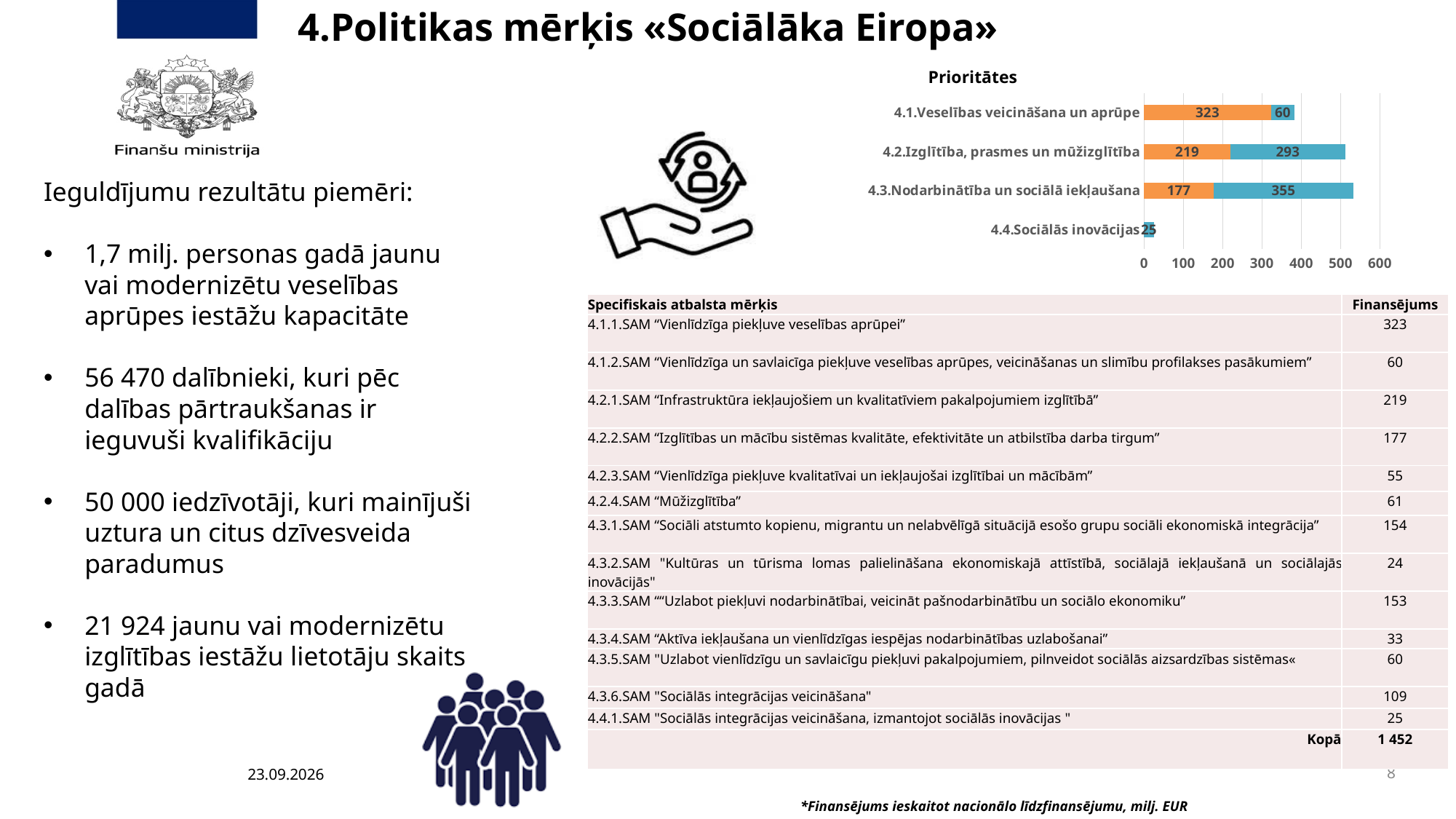
In the Prioritātes chart, which is larger: the blue segment for 4.3.Nodarbinātība un sociālā iekļaušana or the blue segment for 4.2.Izglītība, prasmes un mūžizglītība? 4.3.Nodarbinātība un sociālā iekļaušana What is the value of the blue segment for 4.2.Izglītība, prasmes un mūžizglītība in the Prioritātes chart? 293 What is the total of the stacked bar for 4.2.Izglītība, prasmes un mūžizglītība in the Prioritātes chart? 512 What is the total of the stacked bar for 4.3.Nodarbinātība un sociālā iekļaušana in the Prioritātes chart? 532 What is the title of the bar chart on the slide? Prioritātes Which category has the lowest total in the Prioritātes chart? 4.4.Sociālās inovācijas What is the value of the blue segment for 4.3.Nodarbinātība un sociālā iekļaušana in the Prioritātes chart? 355 What is the value shown for 4.4.Sociālās inovācijas in the Prioritātes chart? 25 How many priority categories are plotted in the Prioritātes chart? 4 In the Prioritātes chart, what is the difference between the orange segment for 4.1.Veselības veicināšana un aprūpe and the orange segment for 4.2.Izglītība, prasmes un mūžizglītība? 104 What is the value of the orange segment for 4.1.Veselības veicināšana un aprūpe in the Prioritātes chart? 323 What kind of chart is the Prioritātes chart? Stacked bar chart